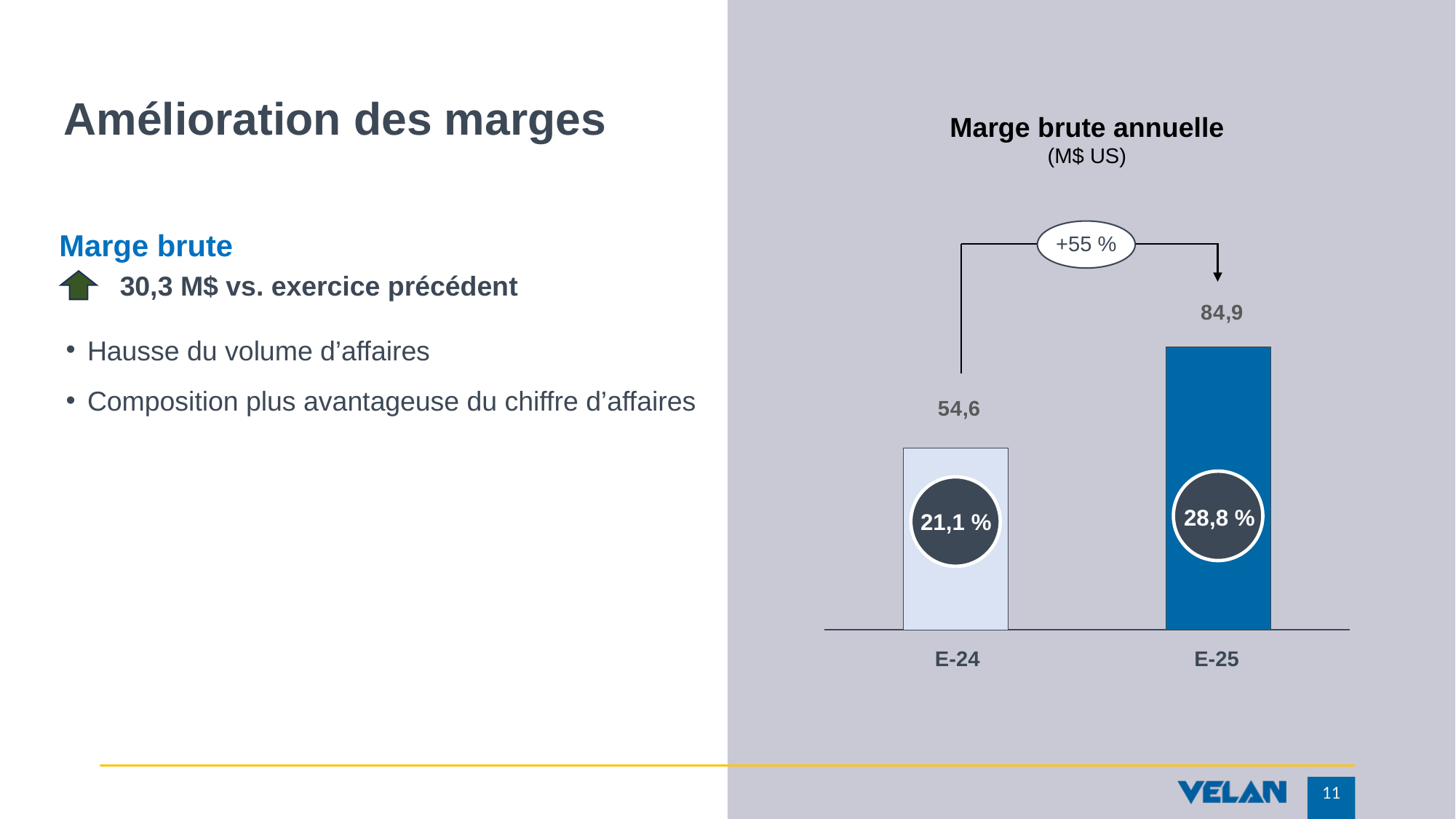
Which year has the higher annual gross margin in the chart? E-25 What gross margin percentage is shown inside the E-24 bar? 21,1 % What is the gross margin value shown for E-25 in the 'Marge brute annuelle' chart? 84,9 What is the difference between the E-25 and E-24 gross margin values in the chart? 30,3 What unit is indicated under the chart title 'Marge brute annuelle'? M$ US Is the gross margin value for E-25 larger or smaller than the value for E-24? larger What percentage change is shown in the oval between the two bars? +55 % How many bars are plotted in the 'Marge brute annuelle' chart? 2 What gross margin percentage is shown inside the E-25 bar? 28,8 % What type of chart is used to show the annual gross margin? bar chart Which year has the lower annual gross margin in the chart? E-24 What is the gross margin value shown for E-24 in the 'Marge brute annuelle' chart? 54,6